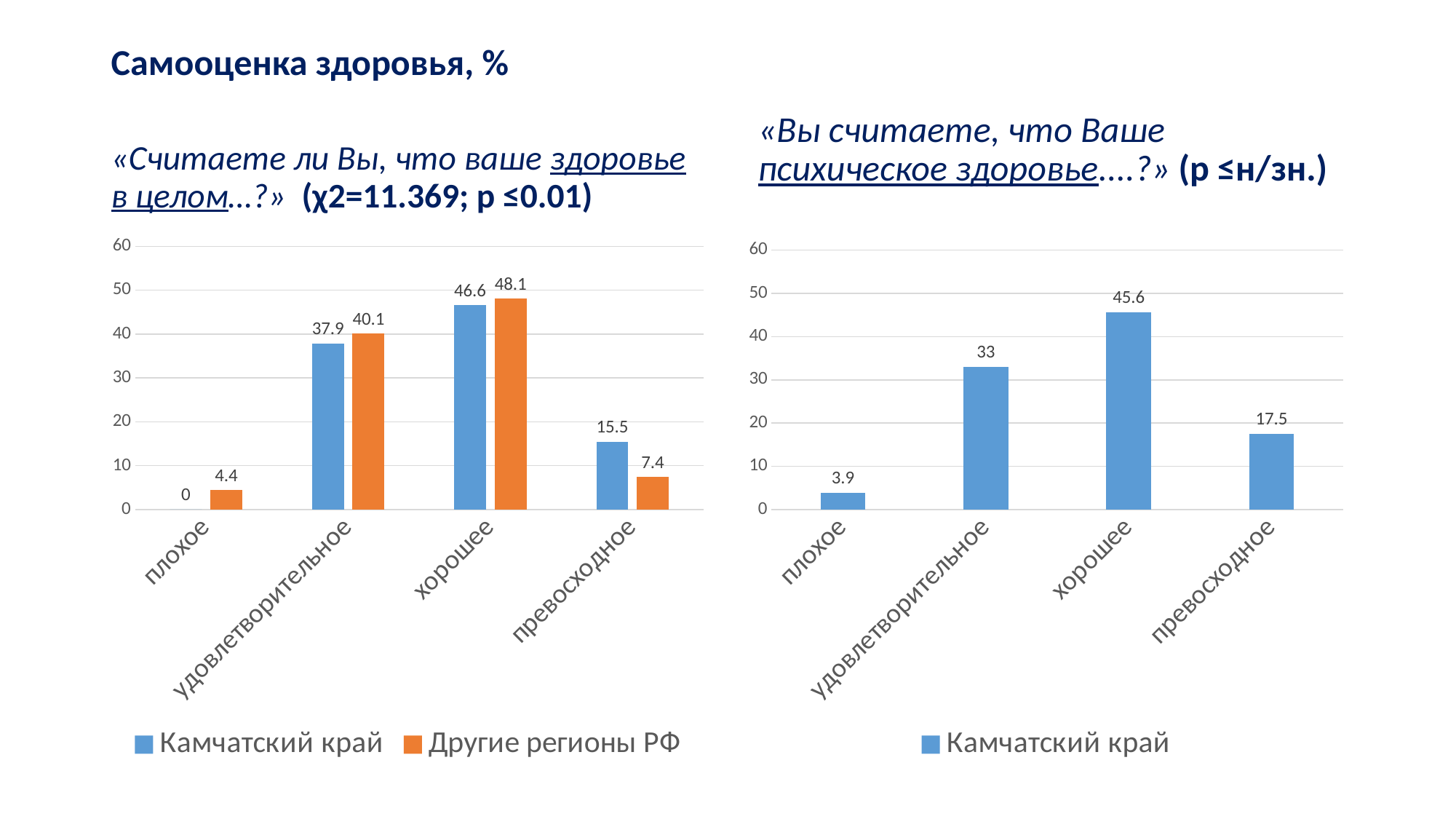
How many series does the legend of the left chart (general health) list? 2 In the right chart (mental health), what is the value for the category удовлетворительное? 33 How many categories are shown on the x axis of the right chart (mental health)? 4 In the left chart (general health), which category has the highest value for Другие регионы РФ? хорошее In the left chart (general health), what is the value for Камчатский край in the category плохое? 0 In the right chart (mental health), which category has the lowest value? плохое In the left chart (general health), what is the value for Другие регионы РФ in the category превосходное? 7.4 In the left chart (general health), what is the difference between Камчатский край and Другие регионы РФ in the category превосходное? 8.1 In the left chart (general health), which is larger in the category удовлетворительное: Камчатский край or Другие регионы РФ? Другие регионы РФ What kind of chart is the right chart (mental health)? bar chart In the right chart (mental health), what is the difference between хорошее and превосходное? 28.1 In the left chart (general health), what is the value for Камчатский край in the category хорошее? 46.6